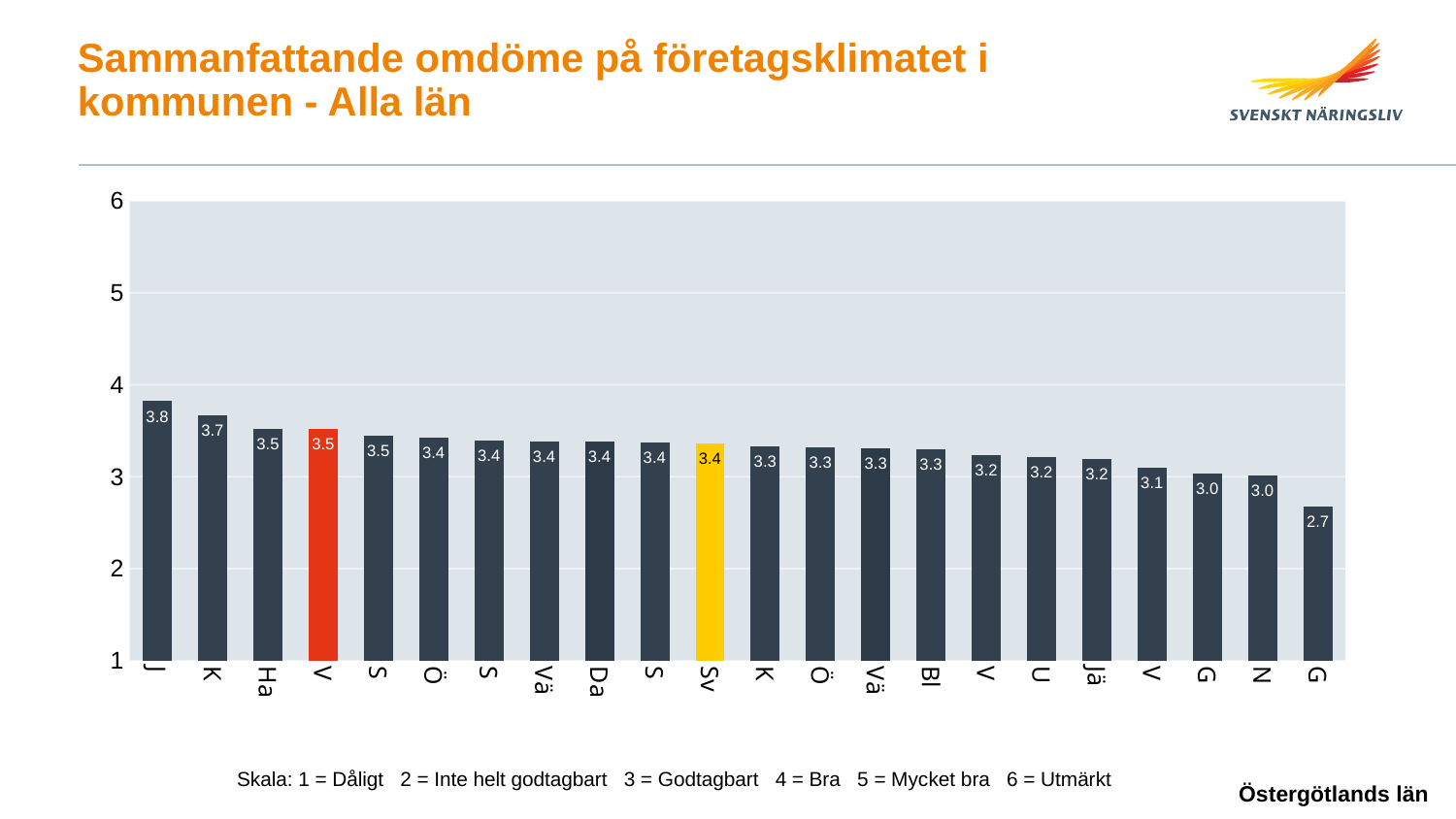
Do the bar values rise or fall from left to right across the chart? fall Which bar has the larger value, the red bar or the yellow bar? the red bar What kind of chart is shown on the slide? bar chart What is the value for the bar labelled Bl? 3.3 What is the difference between the highest and the lowest bar values? 1.1 What is the value for the bar labelled Ha? 3.5 How many bars are plotted in the chart? 22 What is the value of the red bar? 3.5 What is the value of the yellow bar? 3.4 What is the highest value shown in the chart? 3.8 What is the lowest value shown in the chart? 2.7 What is the title of the chart on the slide? Sammanfattande omdöme på företagsklimatet i kommunen - Alla län